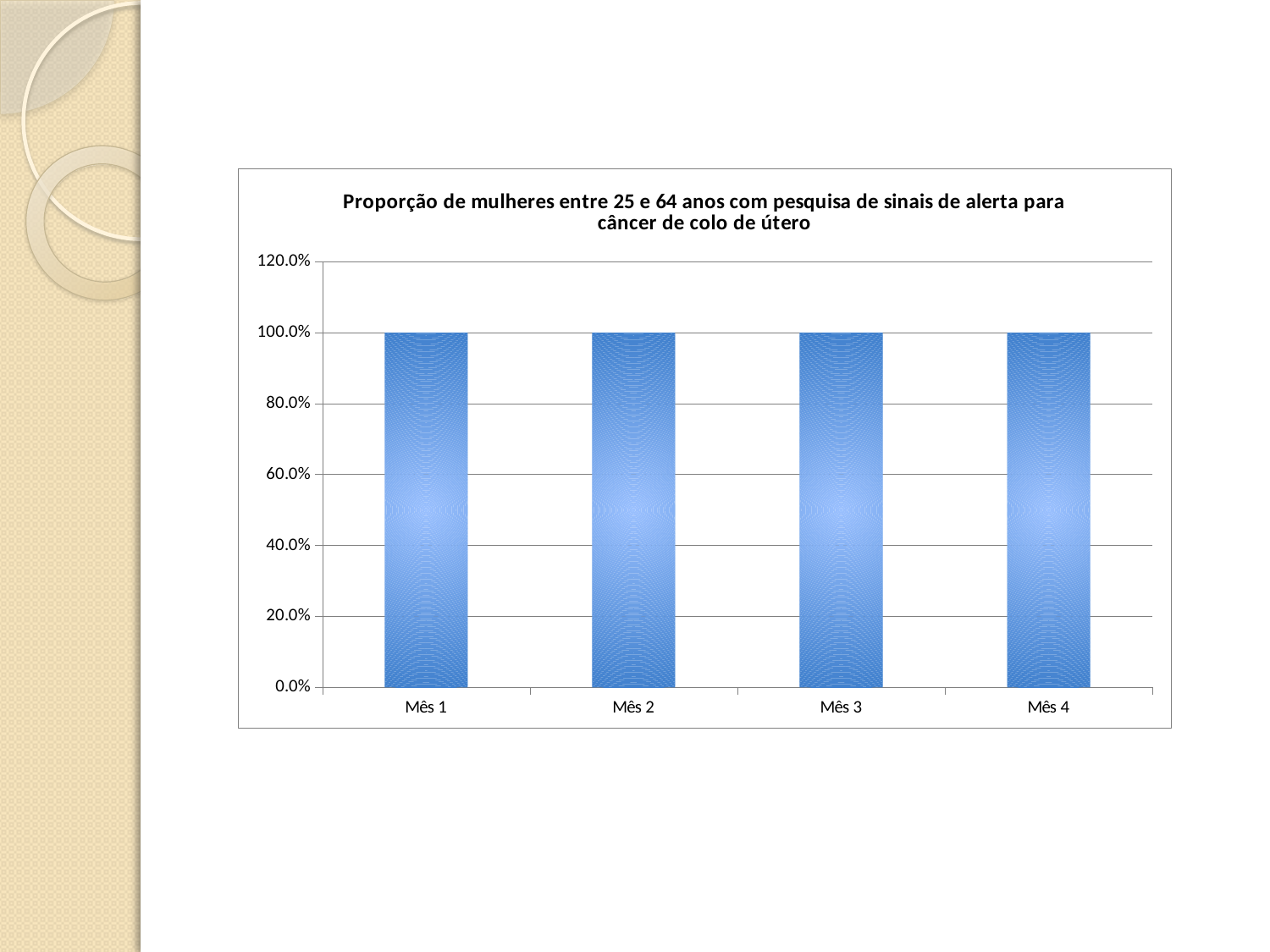
Do the values rise, fall or stay the same from Mês 1 to Mês 4? Stay the same How many categories are shown on the x axis? 4 What is the difference between the values for Mês 1 and Mês 4? 0.0% What is the value for Mês 1? 100.0% Is the value for Mês 4 greater or less than 120.0%? less What is the value for Mês 3? 100.0% What colour are the bars in the chart? Blue Is the value for Mês 2 greater or less than 80.0%? greater What is the title of the chart? Proporção de mulheres entre 25 e 64 anos com pesquisa de sinais de alerta para câncer de colo de útero What is the value for Mês 4? 100.0% What kind of chart is shown on the slide? Bar chart What is the highest value shown on the y axis? 120.0%